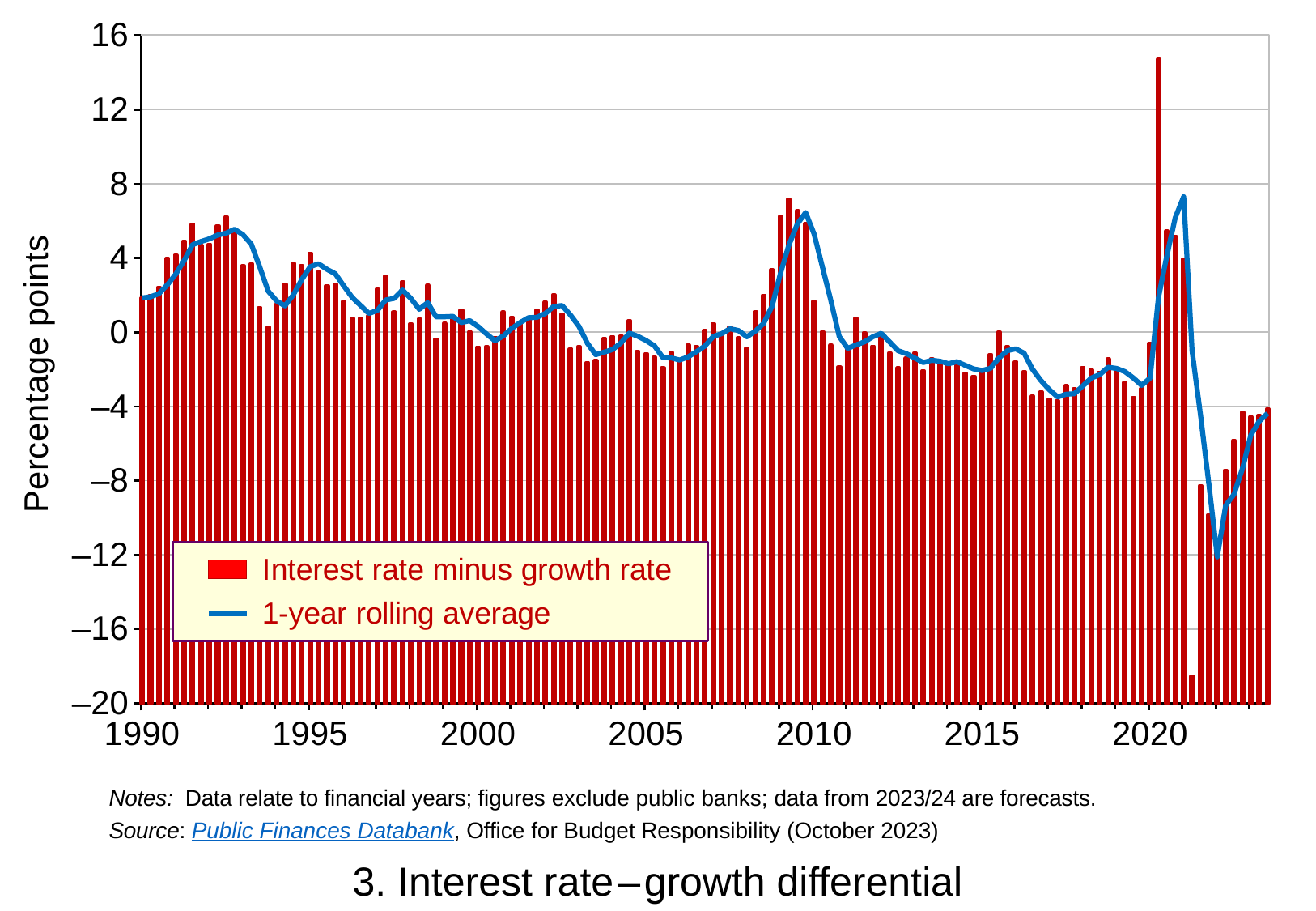
Is the tallest bar, around 2020, greater or less than 12 percentage points? greater What kind of chart is shown on the slide? A bar chart with a line overlay What are the two series named in the legend? Interest rate minus growth rate; 1-year rolling average What is the label on the vertical axis? Percentage points How many series does the legend list? 2 What is the title of the chart? 3. Interest rate–growth differential Is the trough of the 1-year rolling average around 2022 greater or less than -8 percentage points? less Which is higher: the peak of the 1-year rolling average around 1992-93 or its peak around 2010? The peak around 2010 Is the lowest bar, around 2021, greater or less than -16 percentage points? less Around which year does the tallest bar for 'Interest rate minus growth rate' occur? 2020 What is the lowest value shown on the vertical axis? -20